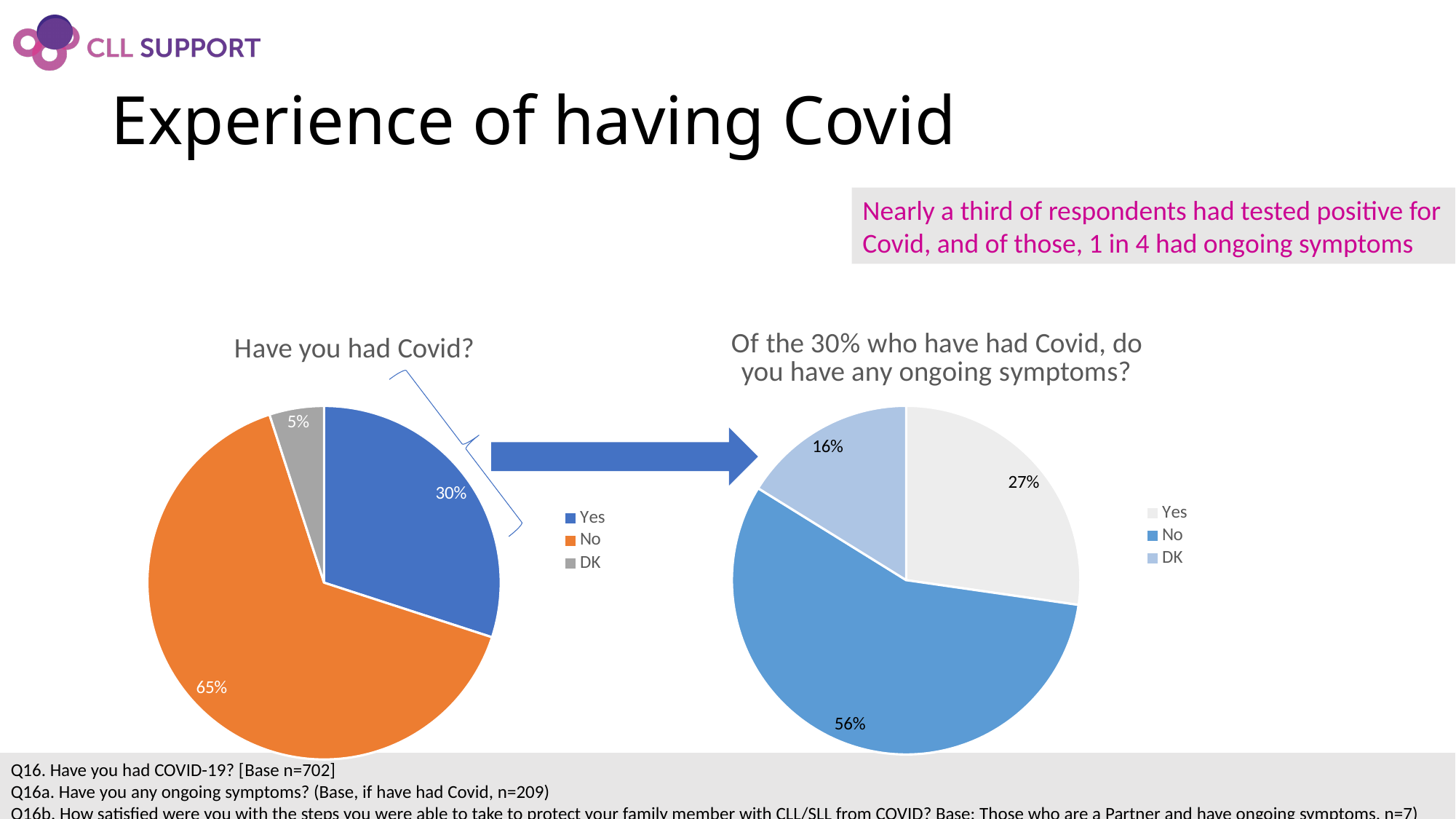
What type of chart is the 'Have you had Covid?' chart? pie chart In the 'Of the 30% who have had Covid, do you have any ongoing symptoms?' chart, what percentage answered No? 56% In the 'Of the 30% who have had Covid, do you have any ongoing symptoms?' chart, what percentage answered DK? 16% In the 'Have you had Covid?' chart, which response has the largest slice? No In the 'Have you had Covid?' chart, what percentage answered DK? 5% In the 'Of the 30% who have had Covid, do you have any ongoing symptoms?' chart, what percentage answered Yes? 27% In the 'Have you had Covid?' chart, which response has the smallest slice? DK In the 'Have you had Covid?' chart, what is the difference between the No and Yes percentages? 35% In the 'Of the 30% who have had Covid, do you have any ongoing symptoms?' chart, is the Yes slice larger or smaller than the DK slice? larger In the 'Have you had Covid?' chart, what percentage answered No? 65% In the 'Have you had Covid?' chart, what percentage answered Yes? 30% In the 'Of the 30% who have had Covid, do you have any ongoing symptoms?' chart, which response has the largest slice? No